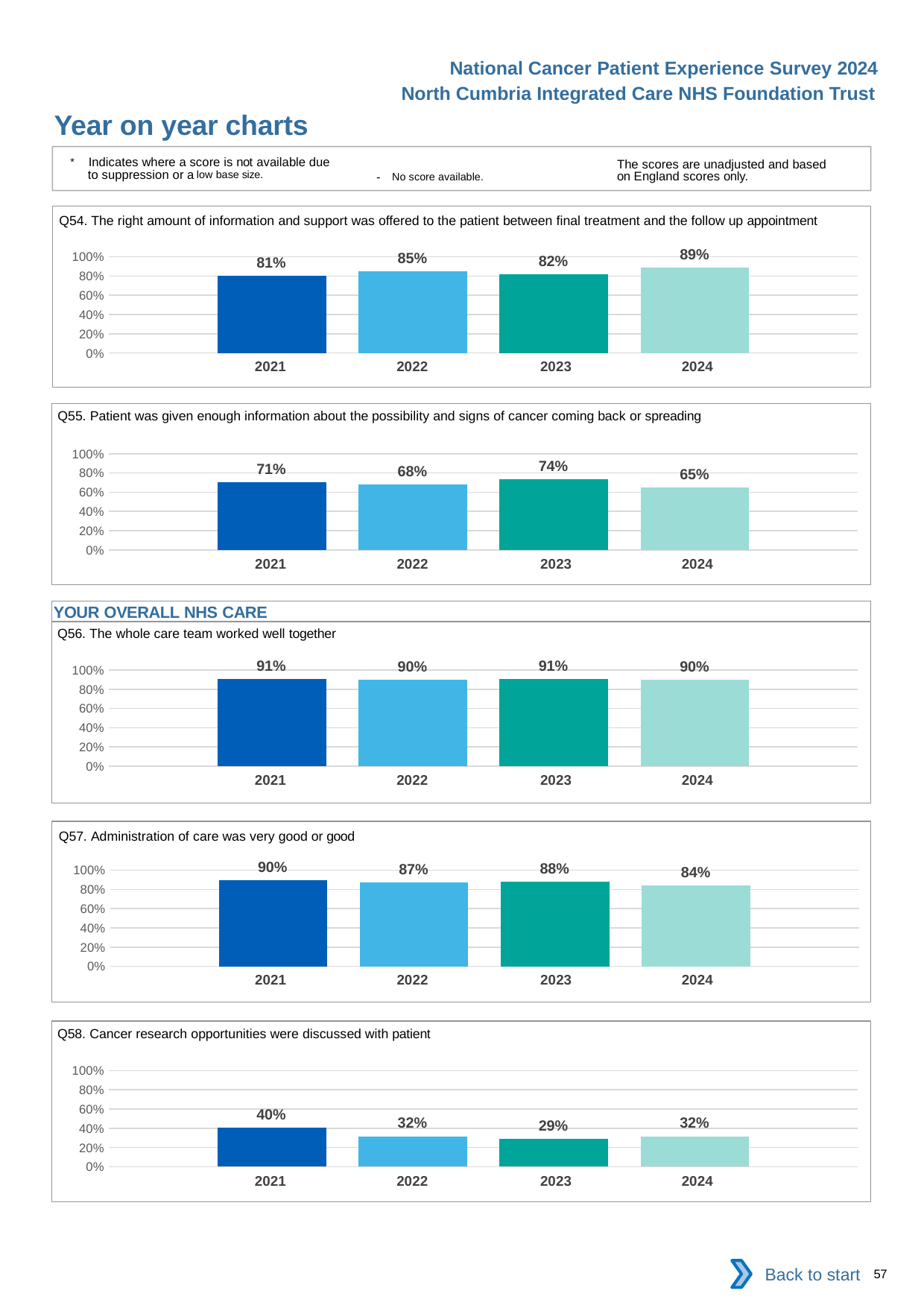
In the Q54 chart, what is the difference between the 2022 and 2021 values? 4 percentage points In the Q58 chart, is the value for 2021 greater or less than 60%? less Which section heading appears above the Q56 chart? YOUR OVERALL NHS CARE In the Q55 chart, which year has the lowest value? 2024 In the Q56 chart, what is the value for 2023? 91% In the Q57 chart, what is the difference between the 2021 and 2024 values? 6 percentage points In the Q54 chart, what is the value for 2024? 89% In the Q58 chart, which is larger, the value for 2021 or the value for 2023? 2021 In the Q55 chart, which year has the highest value? 2023 What kind of chart is the Q57 chart? bar chart In the Q58 chart, what is the value for 2022? 32% How many years are shown in the Q56 chart? 4